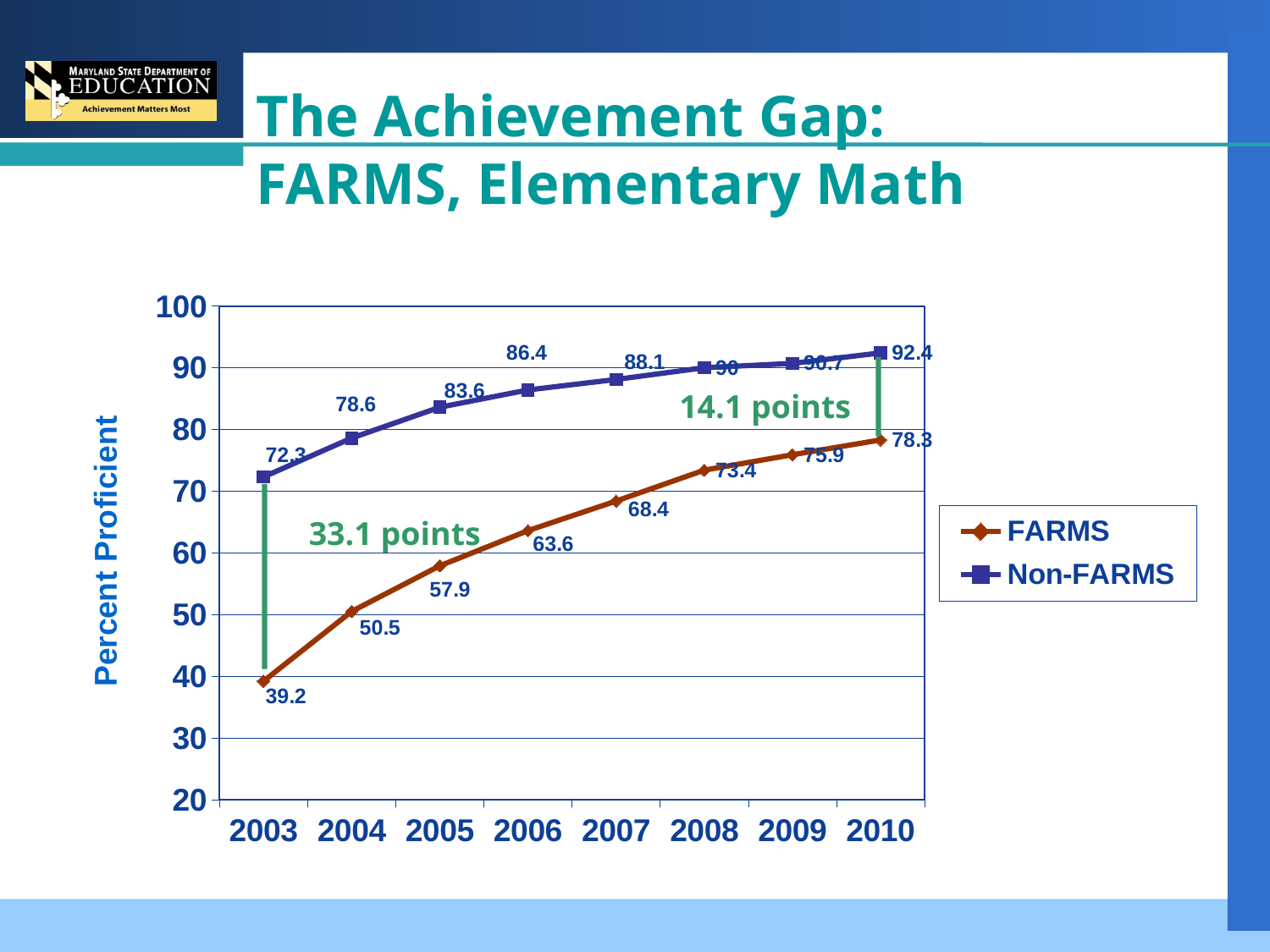
What is the Non-FARMS value for 2006? 86.4 What type of chart is shown on the slide? line chart How many series does the legend list? 2 What is the FARMS percent proficient value for 2003? 39.2 What is the FARMS value for 2007? 68.4 Do the FARMS values rise or fall from 2003 to 2010? rise What is the Non-FARMS percent proficient value for 2010? 92.4 How many years are shown on the x axis? 8 Which series has the larger value in 2005, FARMS or Non-FARMS? Non-FARMS In which year is the Non-FARMS value highest? 2010 What is the difference between the Non-FARMS and FARMS values in 2010? 14.1 In which year is the FARMS value lowest? 2003